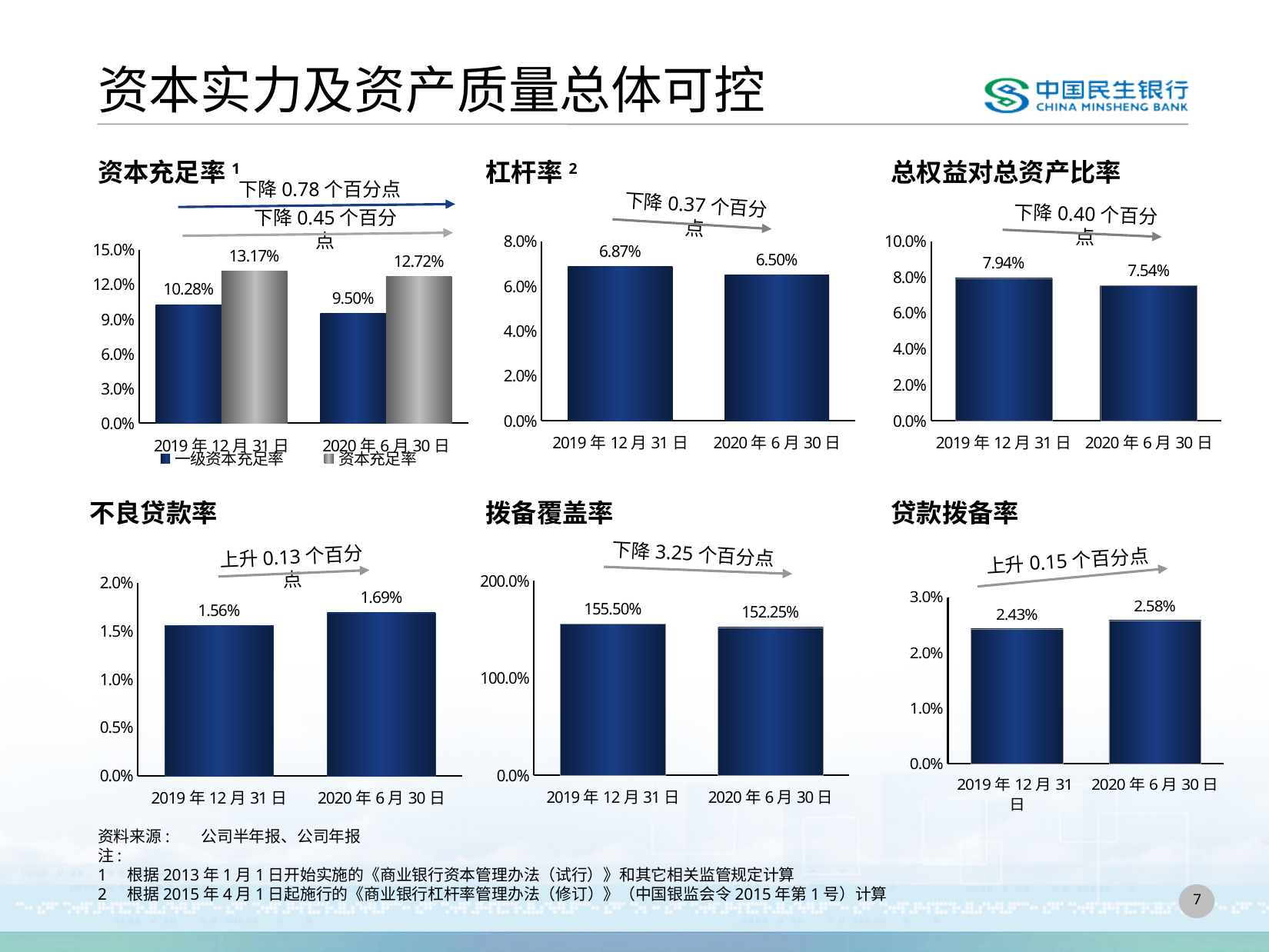
In the 杠杆率 chart, do the values rise or fall from 2019年12月31日 to 2020年6月30日? fall In the 不良贷款率 chart, which date has the higher value? 2020年6月30日 In the 资本充足率 chart, what is the value of 一级资本充足率 for 2019年12月31日? 10.28% What kind of chart is the 贷款拨备率 chart? bar chart In the 总权益对总资产比率 chart, what is the value for 2019年12月31日? 7.94% In the 杠杆率 chart, what is the value for 2020年6月30日? 6.50% In the 不良贷款率 chart, what is the difference between the 2020年6月30日 and 2019年12月31日 values? 0.13 percentage points In the 拨备覆盖率 chart, what is the value for 2019年12月31日? 155.50% How many series does the legend of the 资本充足率 chart list? 2 In the 资本充足率 chart, what is the difference between the 资本充足率 values for 2019年12月31日 and 2020年6月30日? 0.45 percentage points In the 贷款拨备率 chart, which is larger, the value for 2019年12月31日 or 2020年6月30日? 2020年6月30日 In the 资本充足率 chart, what is the value of 资本充足率 for 2020年6月30日? 12.72%